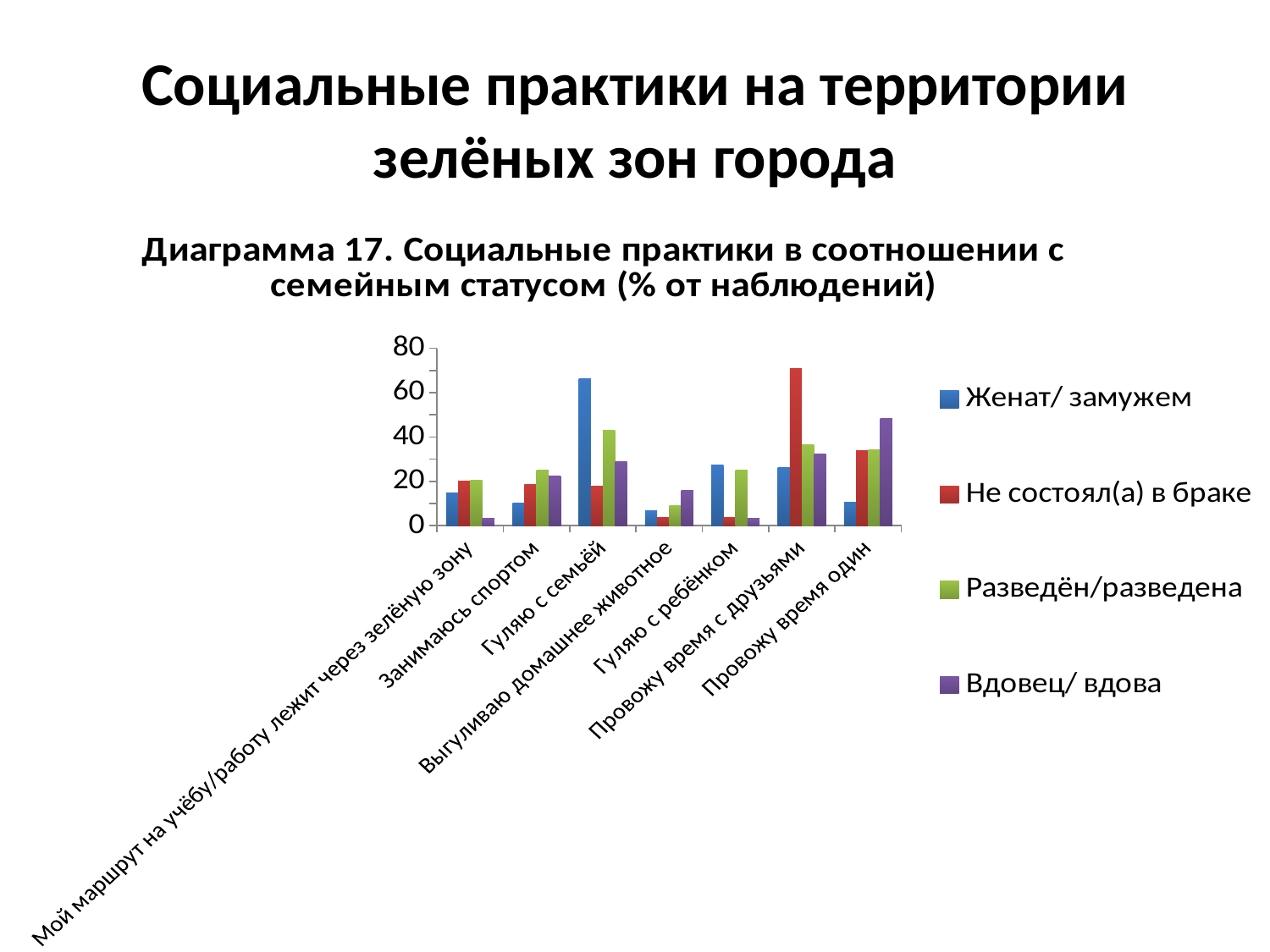
What kind of chart is shown on the slide? bar chart Is the value for Вдовец/ вдова in the category Провожу время один greater or less than 40? greater In the category Гуляю с семьёй, which is larger: Женат/ замужем or Разведён/разведена? Женат/ замужем For the series Вдовец/ вдова, which category has the highest value? Провожу время один For the series Не состоял(а) в браке, which category has the highest value? Провожу время с друзьями In the category Провожу время один, which is larger: Вдовец/ вдова or Женат/ замужем? Вдовец/ вдова How many categories are shown on the x axis? 7 What colour represents the series Вдовец/ вдова in the legend? purple Is the value for Женат/ замужем in the category Гуляю с семьёй greater or less than 60? greater How many series does the legend list? 4 Is the value for Не состоял(а) в браке in the category Провожу время с друзьями greater or less than 60? greater For the series Женат/ замужем, which category has the highest value? Гуляю с семьёй